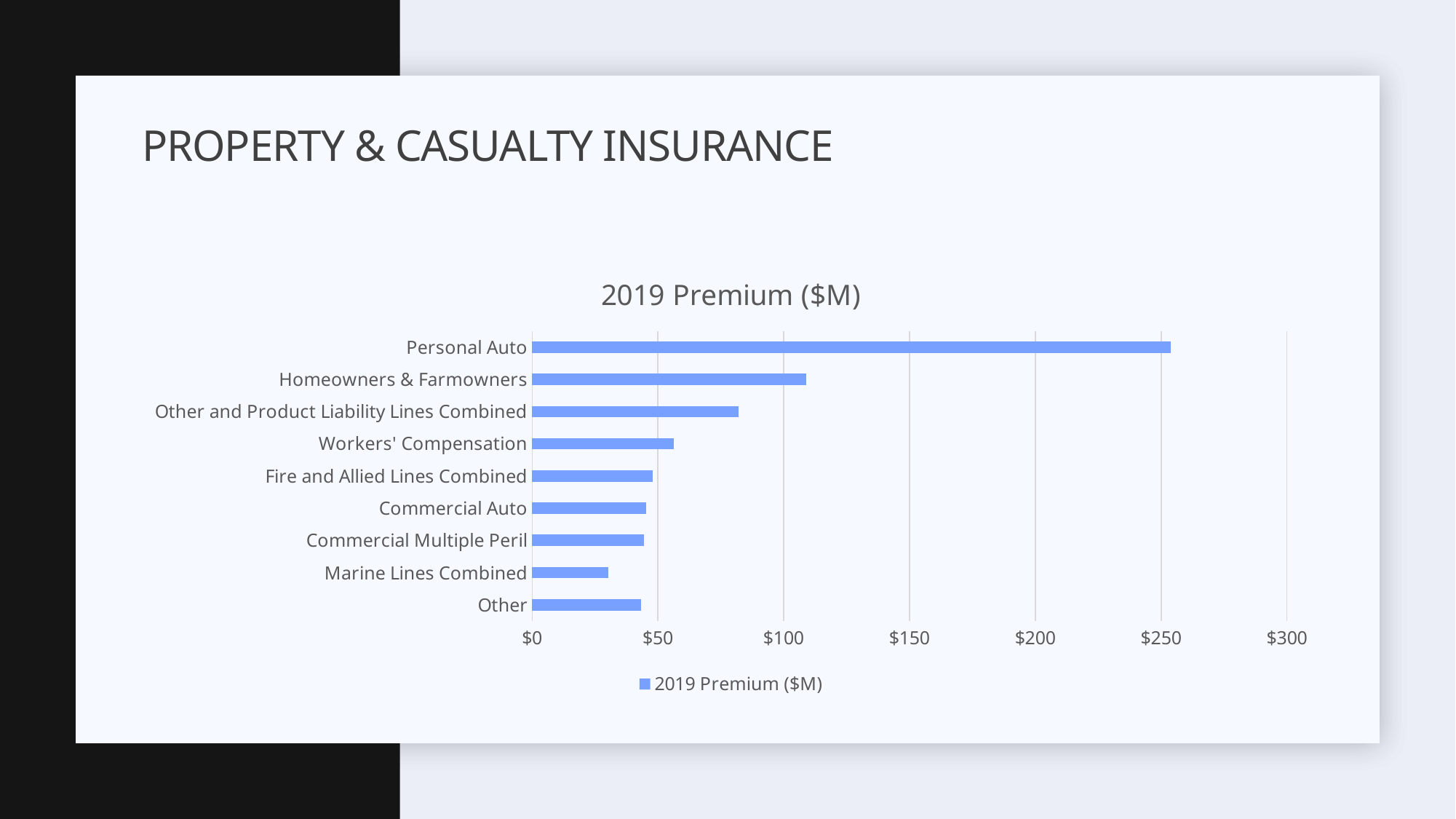
How many categories are plotted in the chart? 9 Which category has the highest 2019 premium? Personal Auto Which category has the lowest 2019 premium? Marine Lines Combined Is the value for Homeowners & Farmowners greater or less than $100? greater Is the value for Personal Auto greater or less than $200? greater What kind of chart is shown on the slide? bar chart Which has a larger 2019 premium, Workers' Compensation or Marine Lines Combined? Workers' Compensation Which has a larger 2019 premium, Personal Auto or Homeowners & Farmowners? Personal Auto Is the value for Marine Lines Combined greater or less than $50? less What is the title of the chart? 2019 Premium ($M) How many series does the legend list? 1